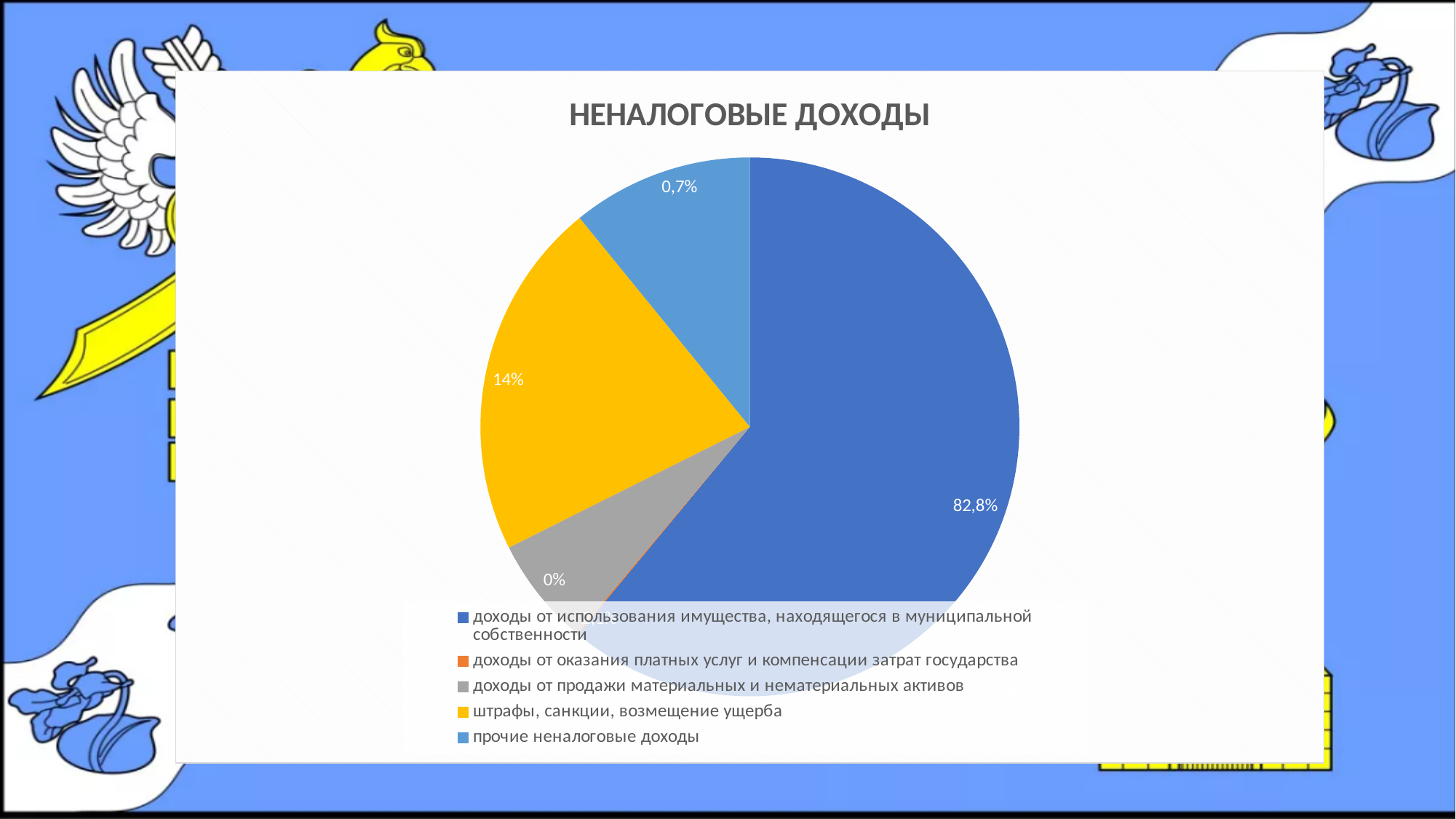
What share of the pie is labelled for "штрафы, санкции, возмещение ущерба"? 14% What colour is the slice for "штрафы, санкции, возмещение ущерба"? yellow What kind of chart is shown on the slide? pie chart What is the difference between the labelled shares of "доходы от использования имущества, находящегося в муниципальной собственности" and "штрафы, санкции, возмещение ущерба"? 68,8% How many categories does the legend of the chart list? 5 What share of the pie is labelled for "доходы от использования имущества, находящегося в муниципальной собственности"? 82,8% What is the title of the chart? НЕНАЛОГОВЫЕ ДОХОДЫ Which category has the largest slice of the pie? доходы от использования имущества, находящегося в муниципальной собственности Which is larger: the slice for "штрафы, санкции, возмещение ущерба" or the slice for "прочие неналоговые доходы"? штрафы, санкции, возмещение ущерба What is the difference between the labelled shares of "штрафы, санкции, возмещение ущерба" and "прочие неналоговые доходы"? 13,3% What share of the pie is labelled for "прочие неналоговые доходы"? 0,7%